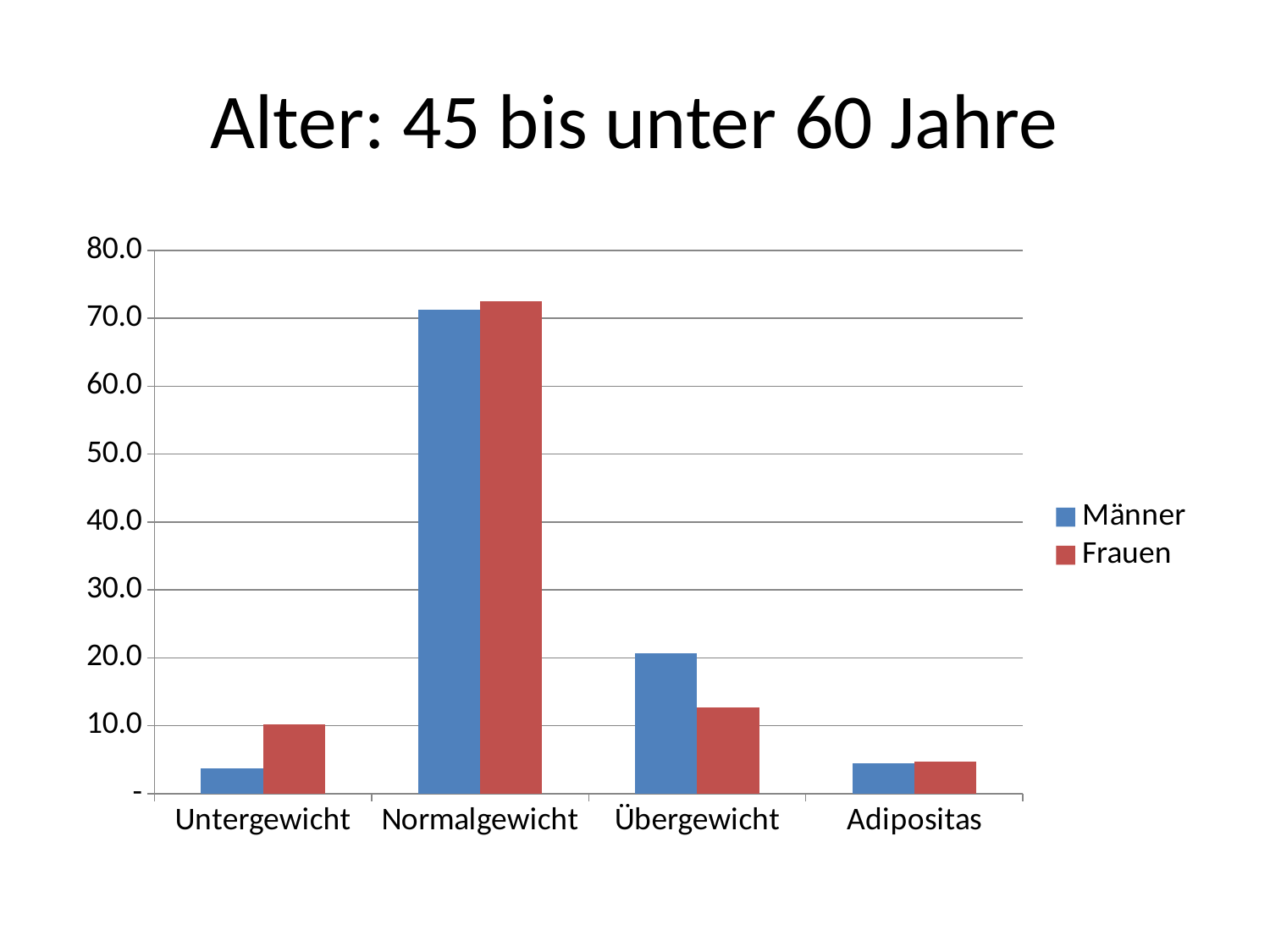
Which category has the highest value for Männer? Normalgewicht For Untergewicht, which series has the larger value, Männer or Frauen? Frauen How many categories are shown on the x axis? 4 What is the title of the chart? Alter: 45 bis unter 60 Jahre Which category has the lowest value for Männer? Untergewicht Which category has the highest value for Frauen? Normalgewicht How many series does the legend list? 2 What kind of chart is shown on the slide? bar chart Which category has the lowest value for Frauen? Adipositas Is the value for Männer in Übergewicht greater or less than 30.0? less Is the value for Frauen in Normalgewicht greater or less than 70.0? greater For Übergewicht, which series has the larger value, Männer or Frauen? Männer